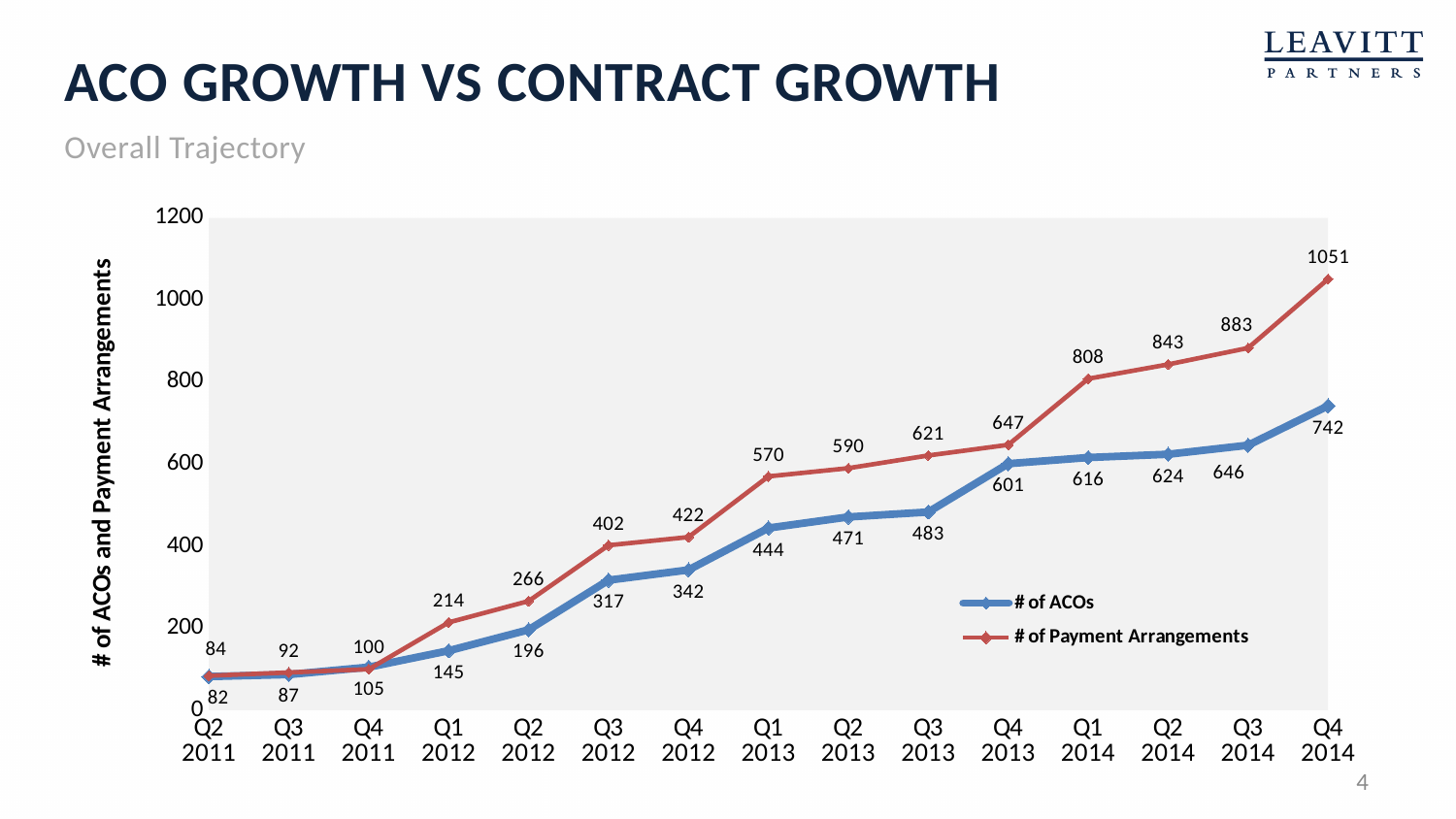
What is the number of ACOs in Q4 2014? 742 What is the number of Payment Arrangements in Q3 2012? 402 What is the number of ACOs in Q1 2013? 444 Do the number of Payment Arrangements rise or fall from Q2 2011 to Q4 2014? Rise In which quarter is the number of Payment Arrangements highest? Q4 2014 Which is larger in Q1 2014: the number of ACOs or the number of Payment Arrangements? # of Payment Arrangements What is the number of Payment Arrangements in Q4 2014? 1051 In which quarter is the number of ACOs lowest? Q2 2011 What is the difference between the number of Payment Arrangements and the number of ACOs in Q4 2014? 309 How many quarters are shown on the x axis? 15 What kind of chart is shown on the slide? Line chart How many series does the legend list? 2